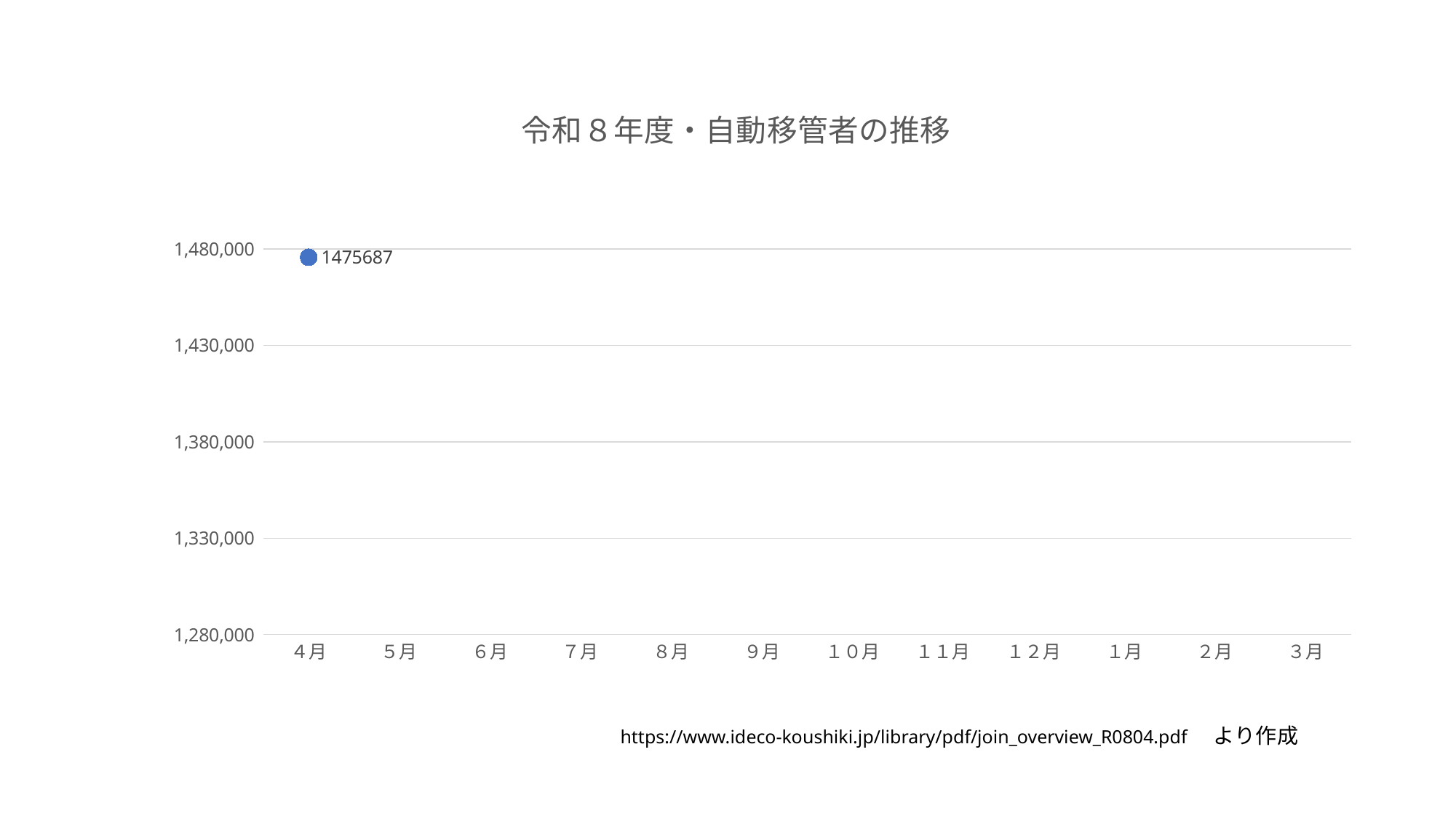
How many data points are actually plotted on the chart? 1 What is the highest value shown on the y axis? 1,480,000 What is the first month label on the x axis? 4月 What is the title of the chart? 令和８年度・自動移管者の推移 What is the last month label on the x axis? 3月 What is the value plotted for 4月? 1475687 Is the value for 4月 greater or less than 1,480,000? less Is the value for 4月 greater or less than 1,430,000? greater Which month is the only one with a plotted data point? 4月 How many month categories are shown on the x axis? 12